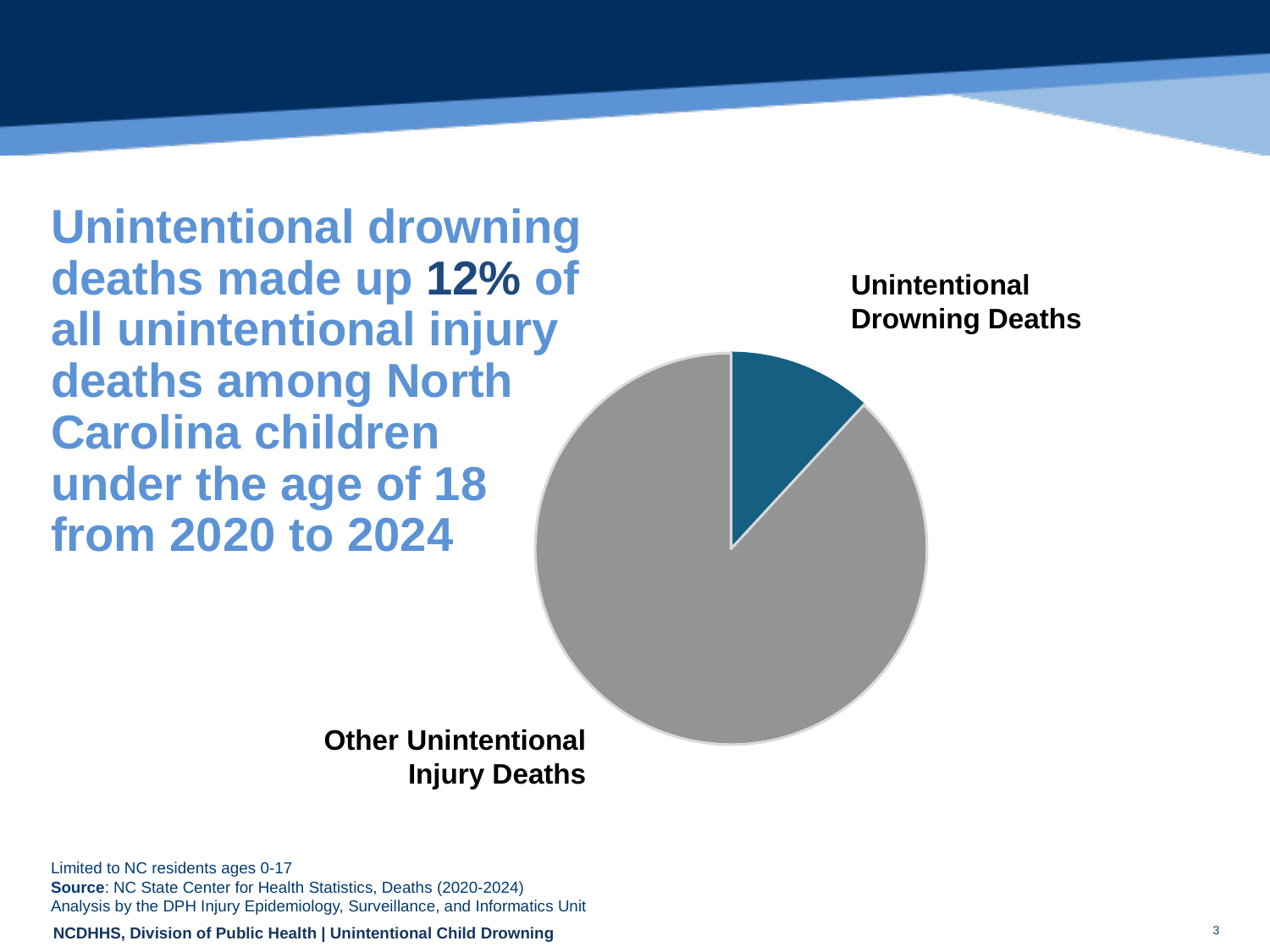
Which slice of the pie chart is the smallest? Unintentional Drowning Deaths What share of the pie does the Unintentional Drowning Deaths slice represent? 12% What colour is the Other Unintentional Injury Deaths slice in the pie chart? gray Which is larger in the pie chart: Unintentional Drowning Deaths or Other Unintentional Injury Deaths? Other Unintentional Injury Deaths How many slices does the pie chart have? 2 What is the label of the slice positioned at the top right of the pie chart? Unintentional Drowning Deaths Which slice of the pie chart is the largest? Other Unintentional Injury Deaths Is the share for Unintentional Drowning Deaths greater or less than 25%? less What colour is the Unintentional Drowning Deaths slice in the pie chart? blue Is the share for Other Unintentional Injury Deaths greater or less than 50%? greater What kind of chart is shown on the slide? pie chart